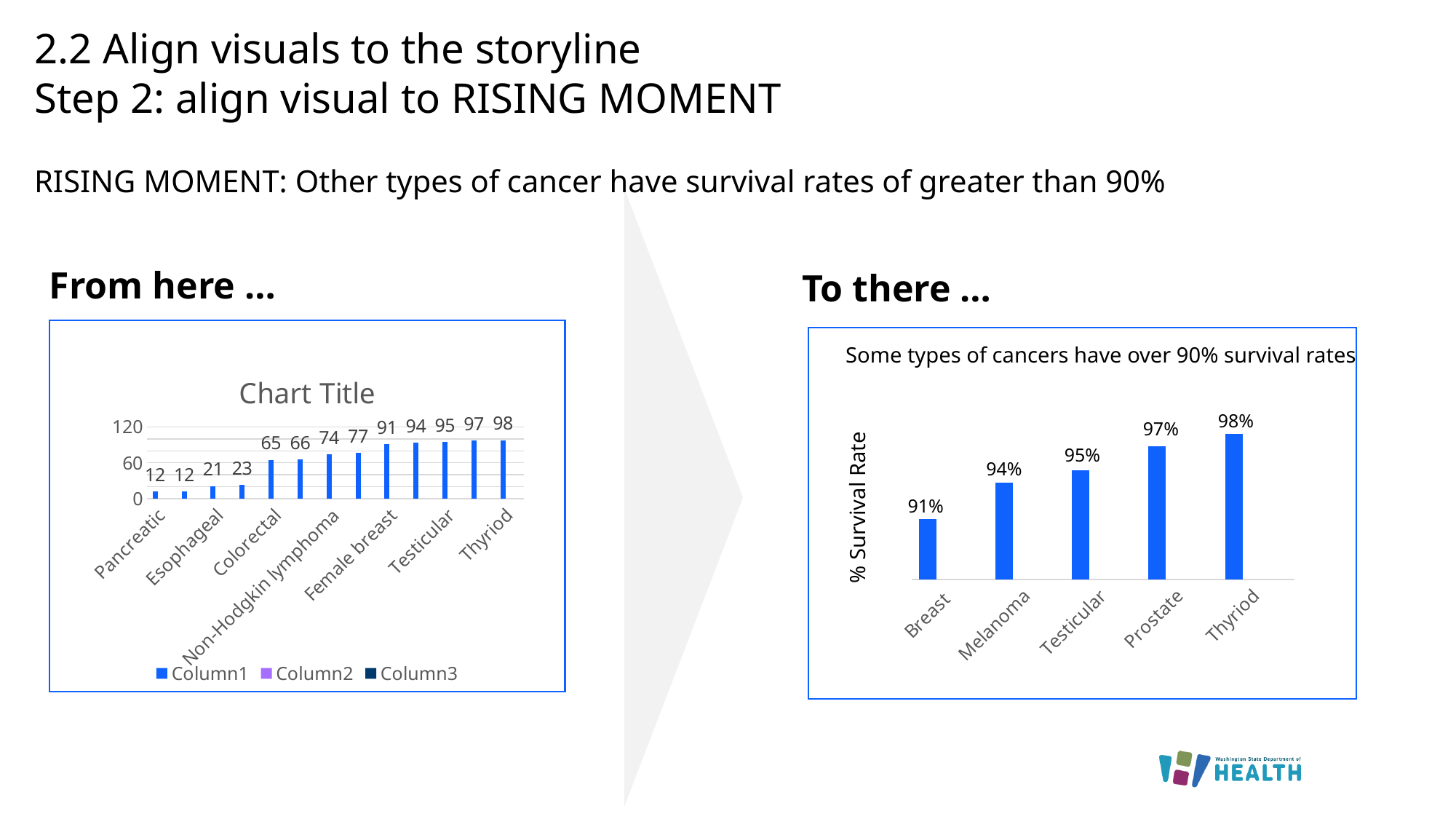
In the left chart titled 'Chart Title', which is larger, the value for Testicular or the value for Female breast? Testicular In the right chart titled 'Some types of cancers have over 90% survival rates', how many cancer types are shown? 5 In the right chart titled 'Some types of cancers have over 90% survival rates', which cancer type has the highest survival rate? Thyriod In the right chart titled 'Some types of cancers have over 90% survival rates', which cancer type has the lowest survival rate? Breast In the right chart titled 'Some types of cancers have over 90% survival rates', what is the survival rate for Melanoma? 94% In the right chart titled 'Some types of cancers have over 90% survival rates', what is the survival rate for Prostate? 97% In the right chart titled 'Some types of cancers have over 90% survival rates', what is the difference between the Thyriod and Breast survival rates? 7% In the left chart titled 'Chart Title', what is the value for Pancreatic? 12 What type of chart is the right chart titled 'Some types of cancers have over 90% survival rates'? bar chart In the left chart titled 'Chart Title', how many series does the legend list? 3 In the right chart titled 'Some types of cancers have over 90% survival rates', do the values rise or fall from left to right? rise In the left chart titled 'Chart Title', what is the value for Colorectal? 65